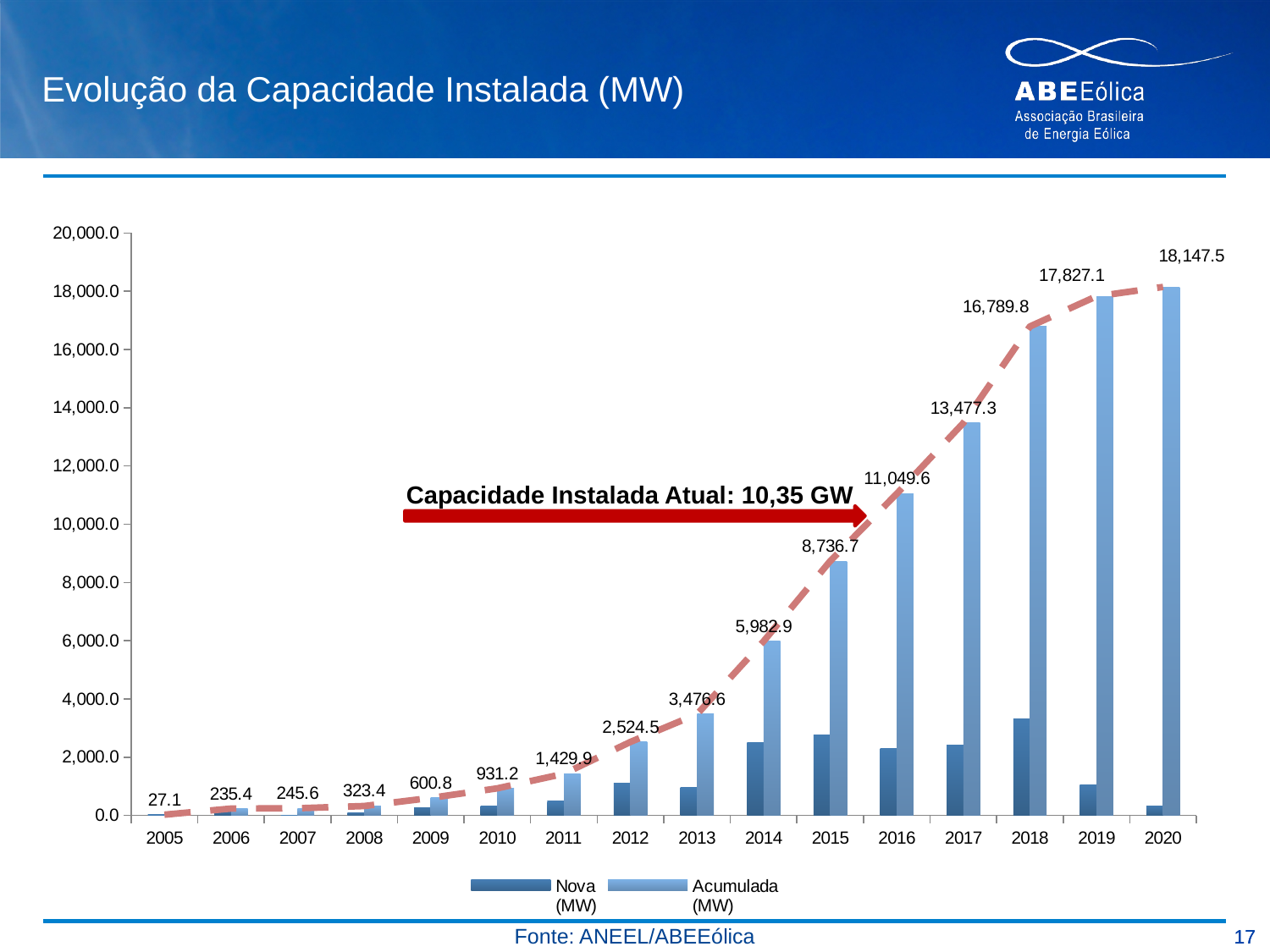
What is the Acumulada (MW) value for 2020? 18,147.5 Which year has the lowest Acumulada (MW) value? 2005 Which is larger, the Acumulada (MW) value for 2013 or for 2014? 2014 How many series does the legend list? 2 What is the Acumulada (MW) value for 2010? 931.2 What kind of chart is shown on the slide? Combination bar and line chart Do the Acumulada (MW) values rise or fall from 2005 to 2020? Rise What is the Acumulada (MW) value for 2015? 8,736.7 What is the difference between the Acumulada (MW) values for 2020 and 2019? 320.4 Is the Nova (MW) value for 2018 greater or less than 4,000.0? less Which year has the highest Acumulada (MW) value? 2020 How many years are shown on the x axis? 16